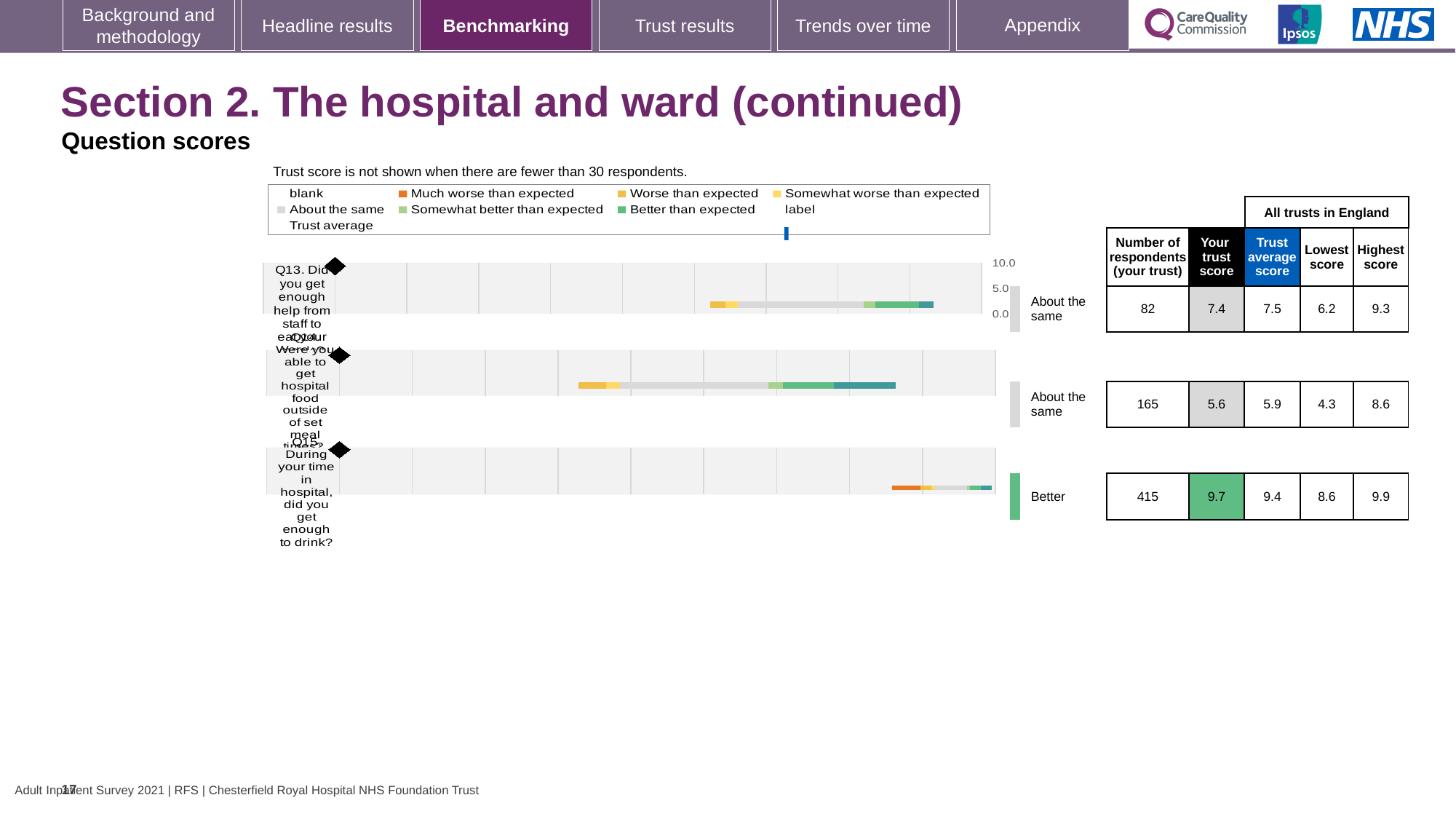
Which question has the lowest trust score? Q14 How many questions are plotted in the chart? 3 How many respondents answered Q14 at this trust? 165 Which benchmark category is shown for Q15? Better What is the trust average score for Q13 (Did you get enough help from staff to eat your meals?)? 7.5 What is the trust score for Q14 (Were you able to get hospital food outside of set meal times?)? 5.6 What type of chart is used to show the question scores on this slide? bar chart Which question has the highest trust score? Q15 For Q15, which is larger: the trust score or the trust average score? the trust score What is the trust score for Q15 (During your time in hospital, did you get enough to drink?)? 9.7 What is the difference between the trust scores for Q15 and Q14? 4.1